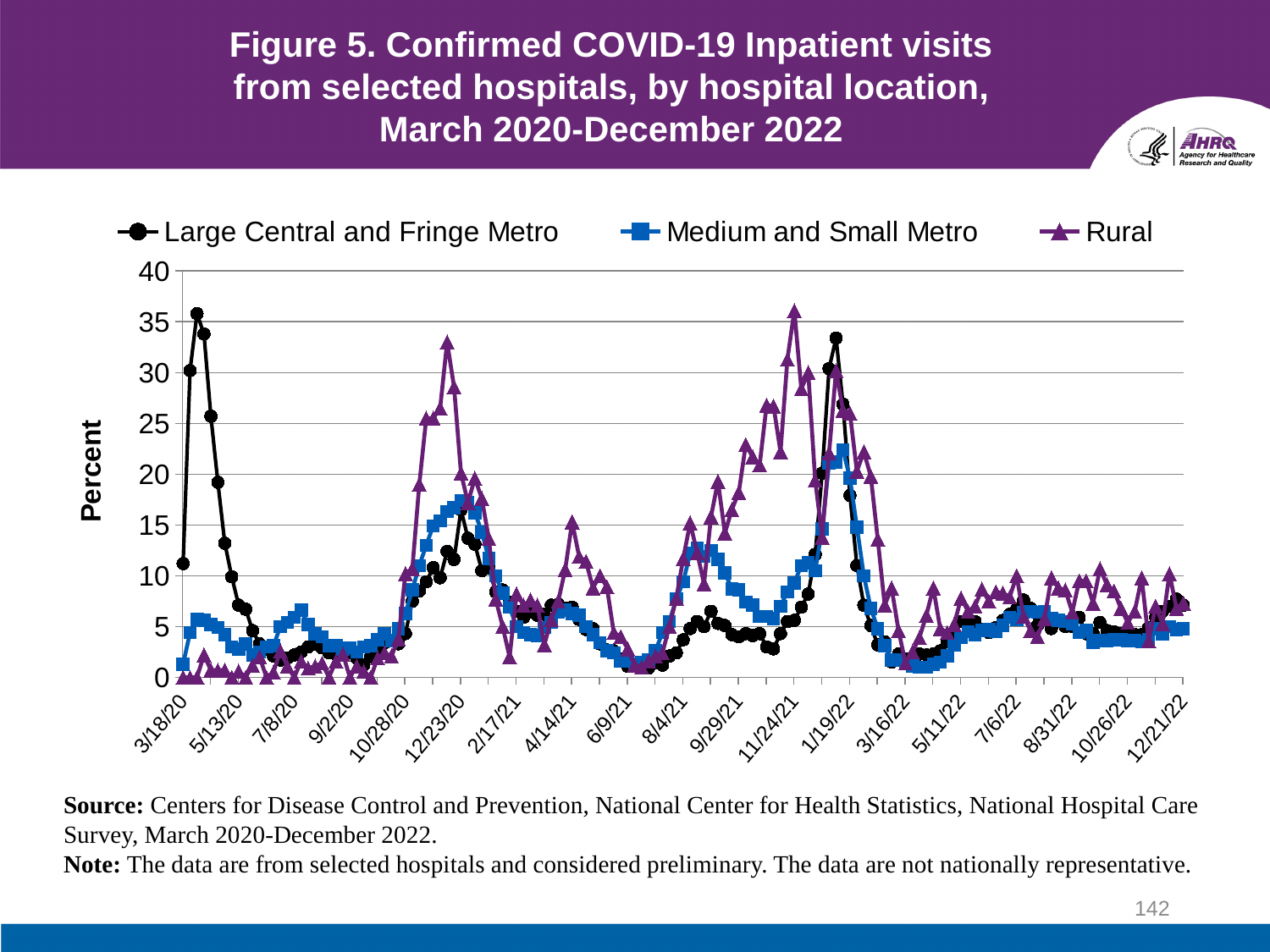
How many series does the legend list? 3 What kind of chart is shown on the slide? line chart What is the title of the chart? Figure 5. Confirmed COVID-19 Inpatient visits from selected hospitals, by hospital location, March 2020-December 2022 Is the peak value of the Rural series near 11/24/21 greater or less than 30? greater At the start of the chart in March 2020, which series has the higher value: Large Central and Fringe Metro or Rural? Large Central and Fringe Metro How many date labels are shown on the x axis? 19 Is the peak value of the Large Central and Fringe Metro series in spring 2020 greater or less than 30? greater Is the value for the Rural series at 6/9/21 greater or less than 5? less Between 9/29/21 and 11/24/21, does the Rural series generally rise or fall? rise Around 12/23/20, which series has the higher value: Rural or Medium and Small Metro? Rural What is the label on the vertical axis? Percent